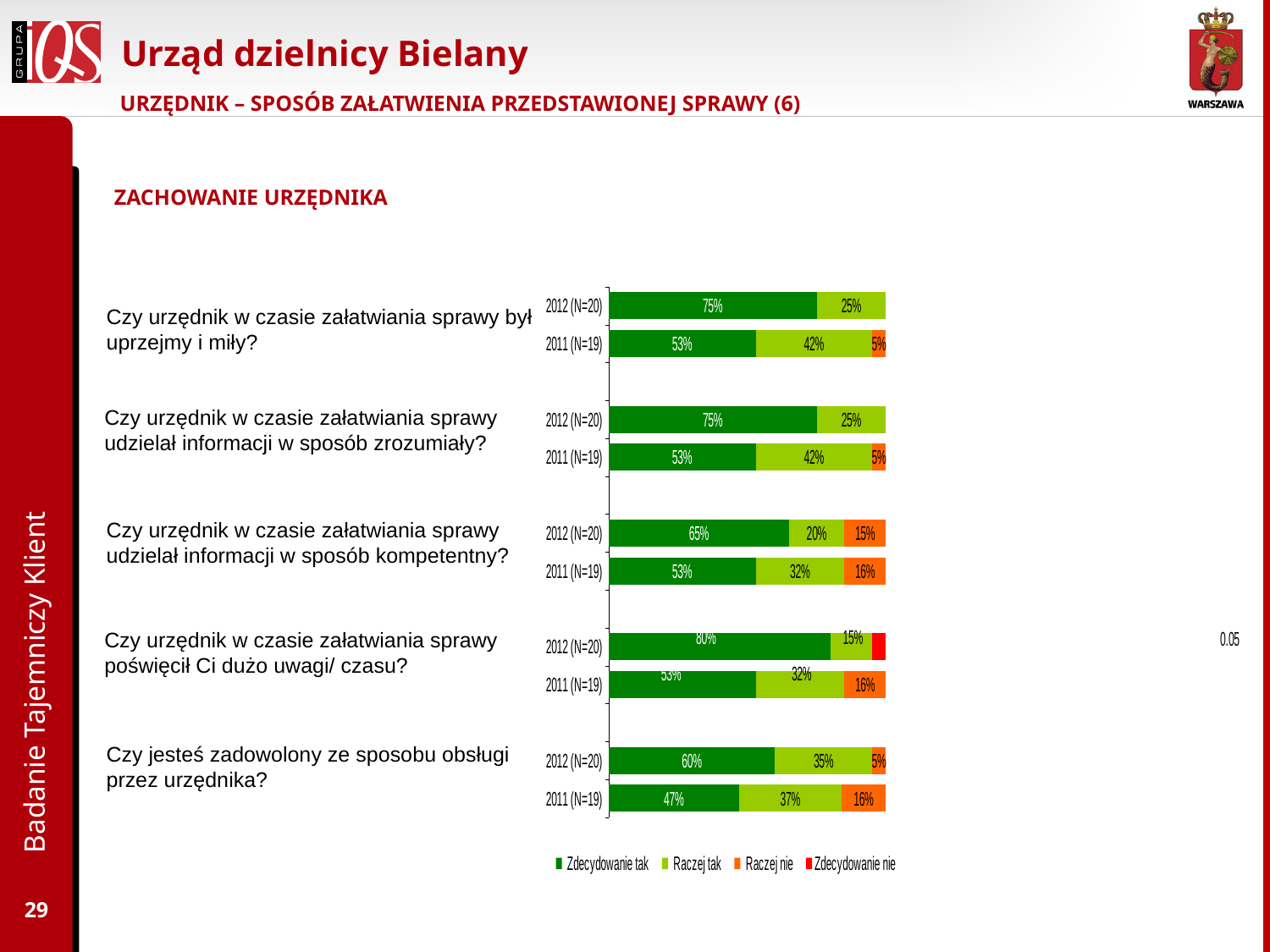
Which legend entry is shown in orange? Raczej nie Which 2011 (N=19) bar has the lowest 'Zdecydowanie tak' value? Czy jesteś zadowolony ze sposobu obsługi przez urzędnika? (47%) What is the 'Raczej tak' value for 2011 (N=19) for the question 'Czy urzędnik w czasie załatwiania sprawy udzielał informacji w sposób zrozumiały?' 42% How many series does the chart legend list? 4 What is the 'Zdecydowanie tak' value for 2012 (N=20) for the question 'Czy urzędnik w czasie załatwiania sprawy był uprzejmy i miły?' 75% For the question 'Czy urzędnik w czasie załatwiania sprawy udzielał informacji w sposób kompetentny?', is the 'Zdecydowanie tak' value larger for 2012 (N=20) or 2011 (N=19)? 2012 (N=20) Which 2012 (N=20) bar has the highest 'Zdecydowanie tak' value? Czy urzędnik w czasie załatwiania sprawy poświęcił Ci dużo uwagi/ czasu? (80%) What is the 'Zdecydowanie tak' value for 2011 (N=19) for the question 'Czy jesteś zadowolony ze sposobu obsługi przez urzędnika?' 47% What is the combined 'Zdecydowanie tak' and 'Raczej tak' total for 2012 (N=20) for the question 'Czy jesteś zadowolony ze sposobu obsługi przez urzędnika?' 95% What kind of chart is shown on the slide? stacked bar chart What is the 'Raczej nie' value for 2012 (N=20) for the question 'Czy urzędnik w czasie załatwiania sprawy udzielał informacji w sposób kompetentny?' 15% For the question 'Czy jesteś zadowolony ze sposobu obsługi przez urzędnika?', what is the difference between the 'Zdecydowanie tak' values for 2012 (N=20) and 2011 (N=19)? 13 percentage points